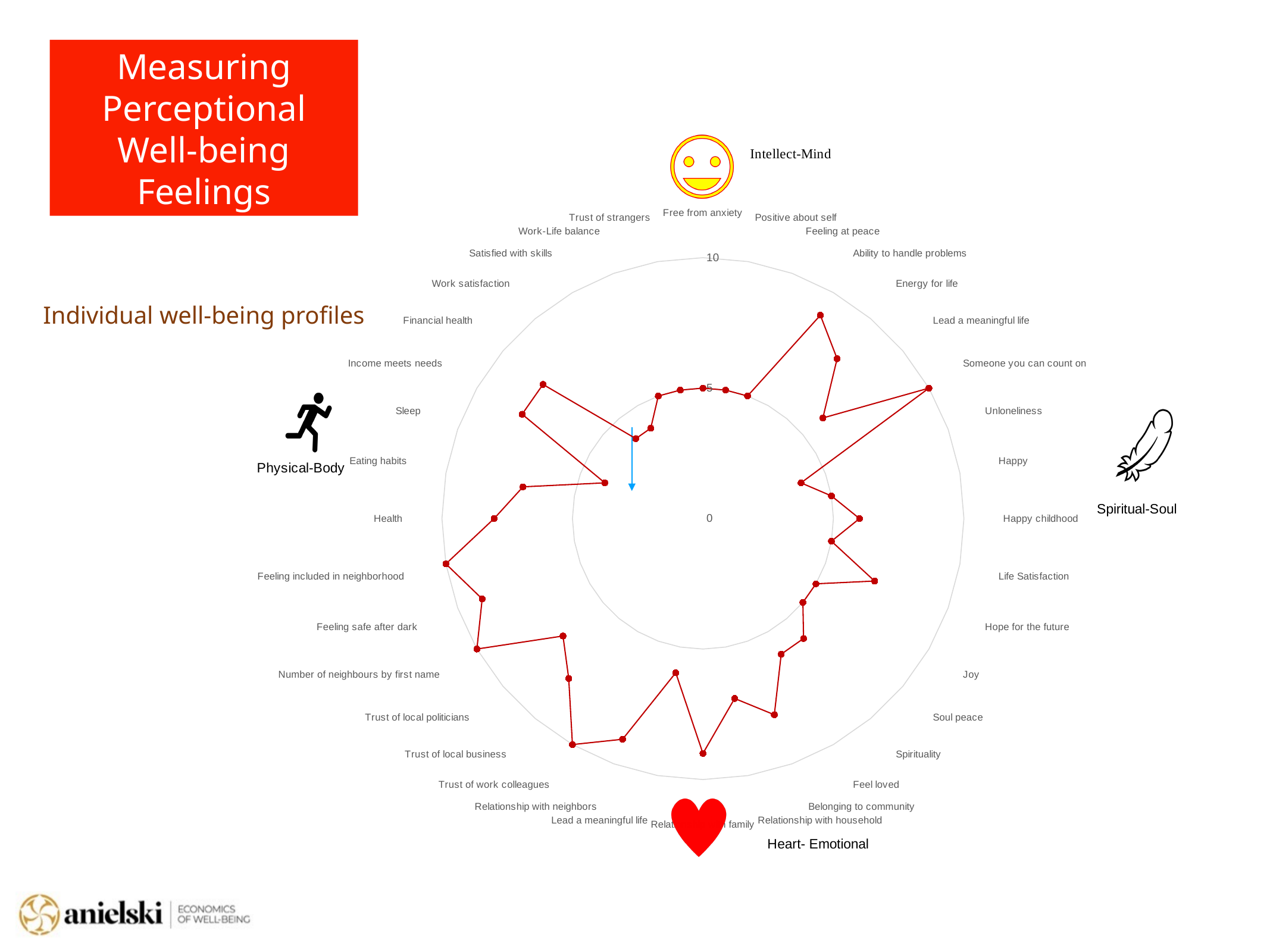
Is the value for Someone you can count on greater or less than 5? greater What is the highest value marked on the chart's axis? 10 Is the value for Feeling safe after dark greater or less than 5? greater Is the value for Unloneliness greater or less than 5? less What kind of chart is shown on the slide? Radar chart Which has the larger value, Health or Sleep? Health Which has the larger value, Someone you can count on or Unloneliness? Someone you can count on Which well-being domain is labelled at the top of the chart next to the smiley face? Intellect-Mind